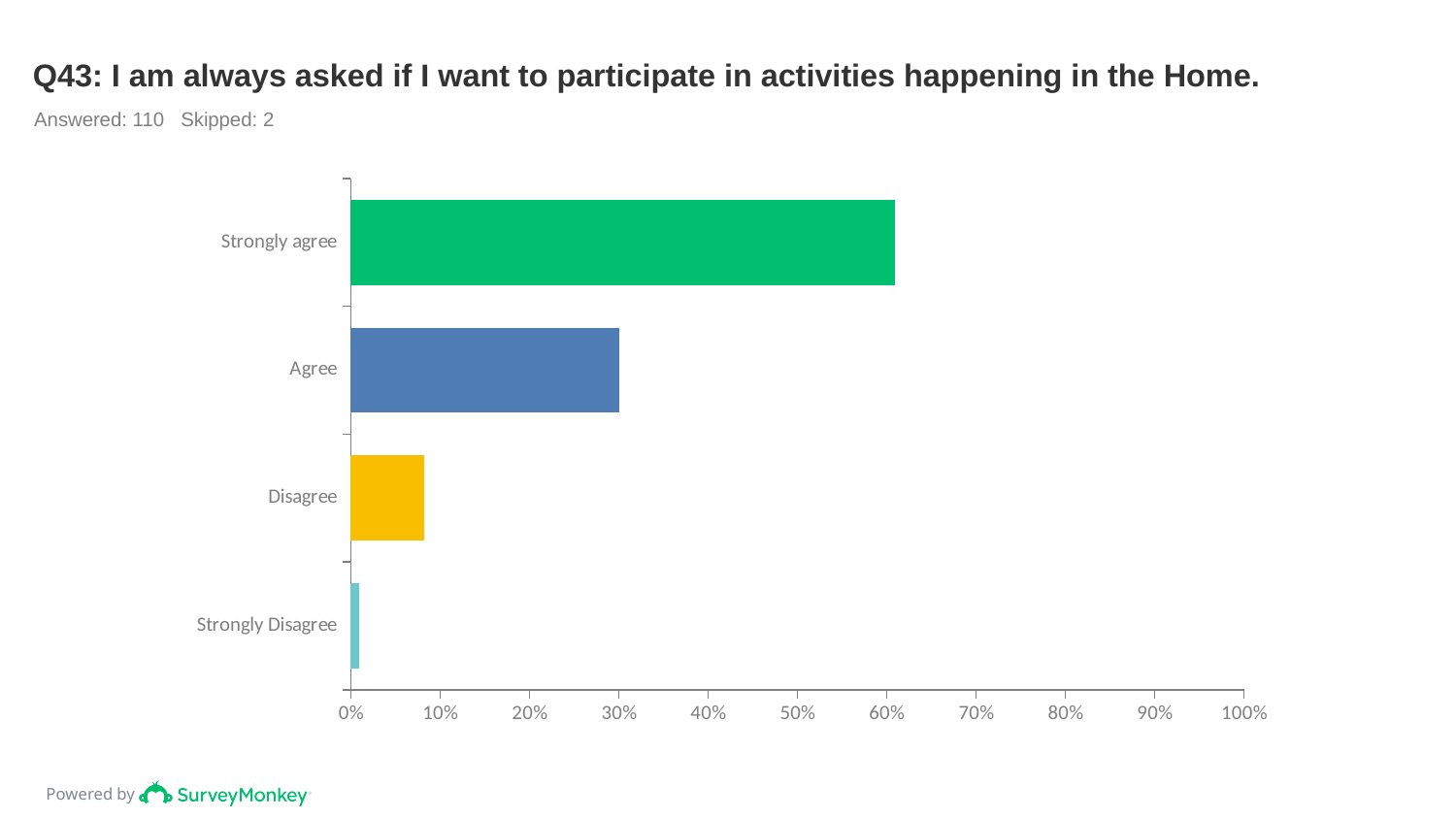
Is the value for Agree greater or less than 40%? less Is the value for Strongly Disagree greater or less than 10%? less Is the value for Strongly agree greater or less than 50%? greater What is the title of the chart? Q43: I am always asked if I want to participate in activities happening in the Home. What colour is the bar for Strongly agree? green Which is larger, the value for Strongly agree or the value for Agree? Strongly agree How many response categories are shown in the chart? 4 Which is larger, the value for Agree or the value for Disagree? Agree Which response category has the highest value? Strongly agree Which response category has the lowest value? Strongly Disagree What kind of chart is shown on the slide? bar chart